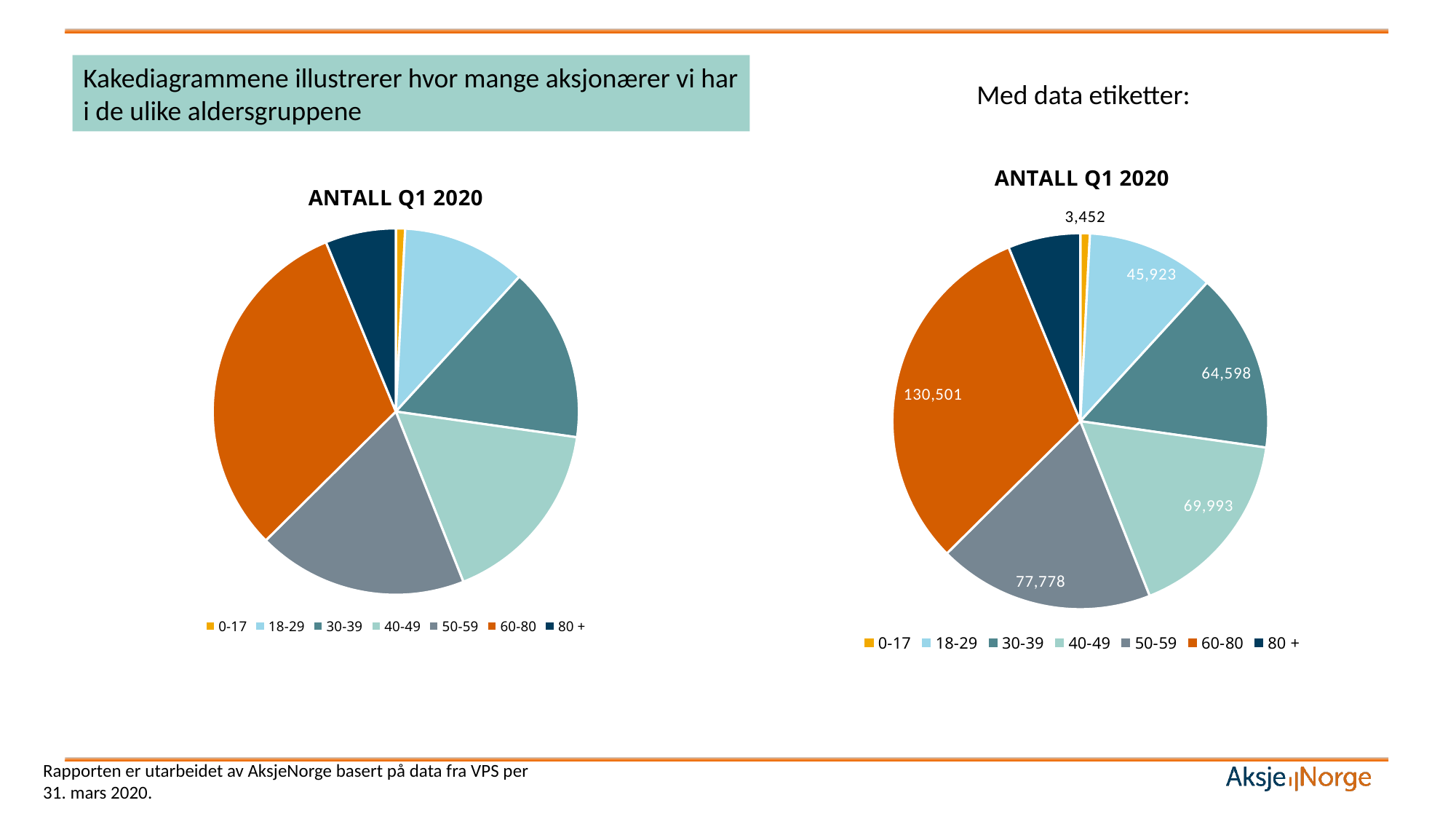
What is the title of the right-hand pie chart? ANTALL Q1 2020 In the right-hand pie chart (with data labels), what is the value for the 0-17 age group? 3,452 In the right-hand pie chart (with data labels), what is the value for the 18-29 age group? 45,923 How many age groups does the legend of the left-hand pie chart list? 7 In the left-hand pie chart, which slice is larger: 30-39 or 18-29? 30-39 In the right-hand pie chart (with data labels), what is the value for the 50-59 age group? 77,778 In the right-hand pie chart (with data labels), what is the difference between the values for 50-59 and 40-49? 7,785 In the right-hand pie chart (with data labels), what is the difference between the values for 60-80 and 30-39? 65,903 In the left-hand pie chart, which age group has the smallest slice? 0-17 What type of chart is shown on the left side of the slide? Pie chart In the right-hand pie chart (with data labels), which age group has the largest slice? 60-80 In the right-hand pie chart (with data labels), what is the value for the 60-80 age group? 130,501